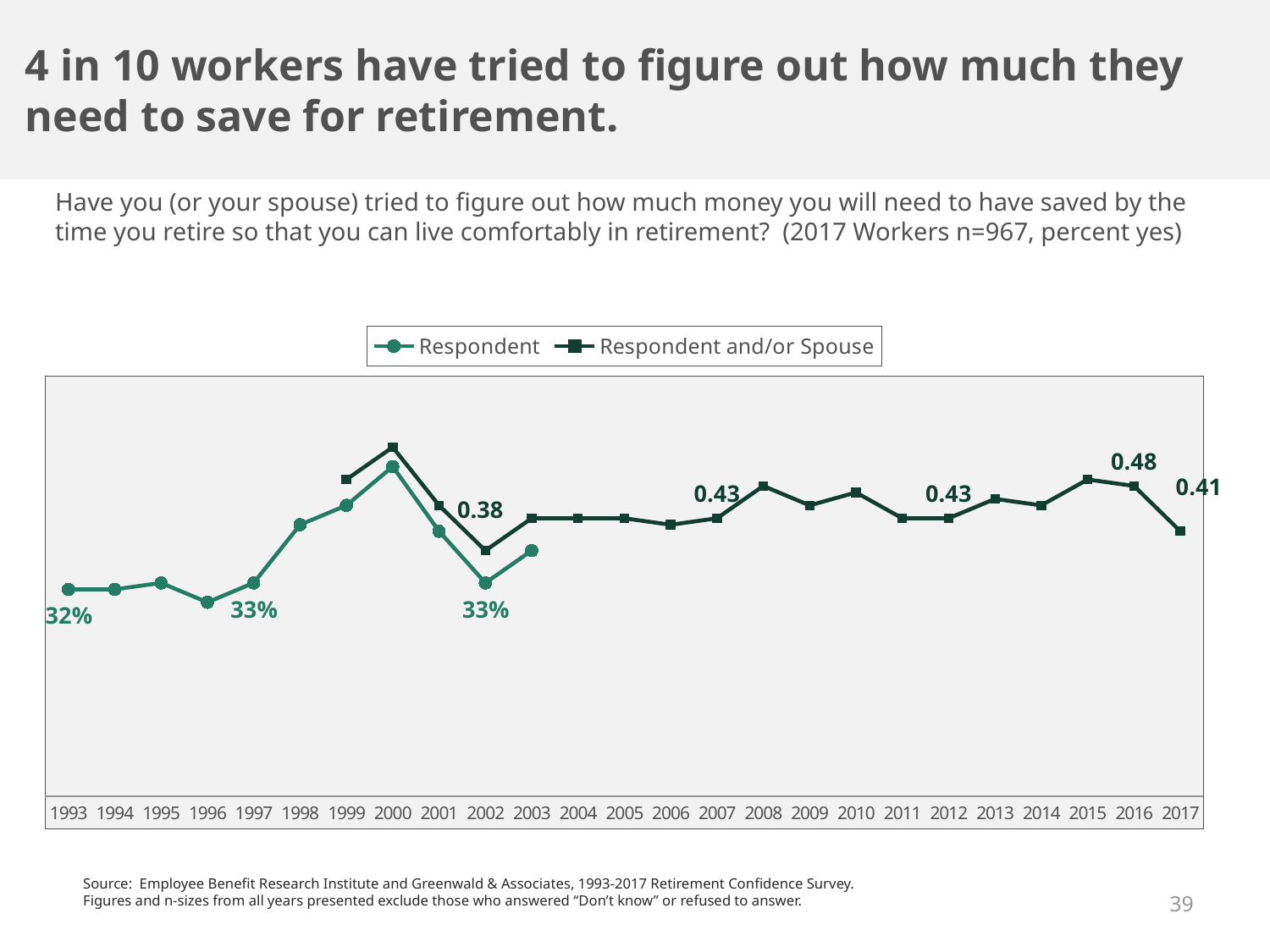
What is the value for Respondent in 1997? 33% What is the value for Respondent in 2002? 33% What kind of chart is shown on the slide? Line chart What is the value for Respondent in 1993? 32% What is the value for Respondent and/or Spouse in 2007? 0.43 How many series does the legend list? 2 What is the value for Respondent and/or Spouse in 2002? 0.38 Which is larger for Respondent and/or Spouse, the value in 2015 or the value in 2017? 2015 What is the value for Respondent and/or Spouse in 2017? 0.41 What are the two series named in the legend? Respondent; Respondent and/or Spouse How many years are shown on the x axis? 25